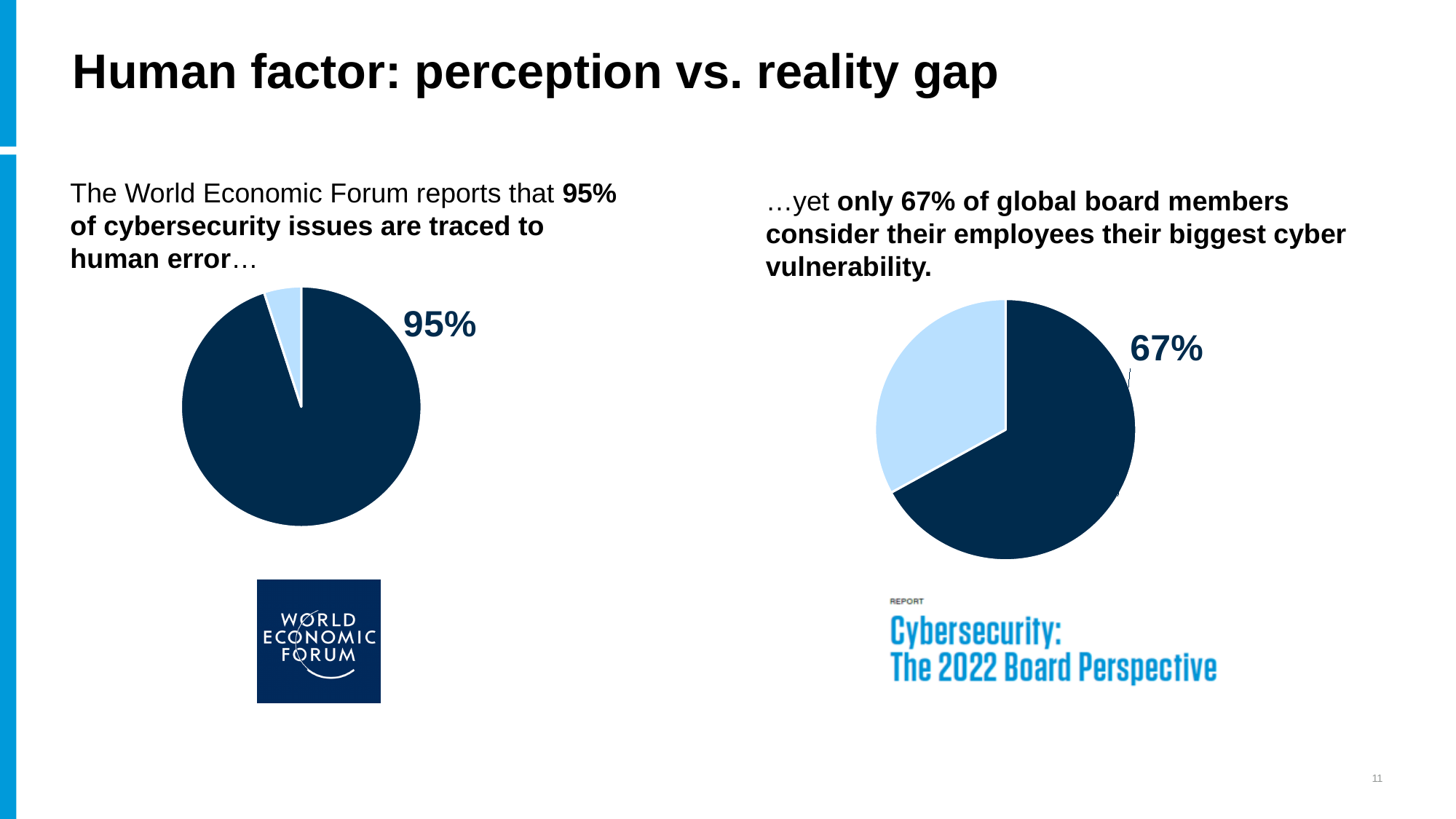
In the right pie chart, is the labelled slice greater or less than 50% of the pie? greater How many slices does the right pie chart have? 2 In the right pie chart, what share of the pie does the light-blue slice represent? 33% What is the difference between the labelled share in the left pie chart (95%) and the labelled share in the right pie chart (67%)? 28 percentage points In the right pie chart, what percentage is shown for the large dark slice? 67% What colour is the slice labelled 95% in the left pie chart? Dark navy blue How many slices does the left pie chart have? 2 What kind of chart is the left chart on the slide? Pie chart What kind of chart is the right chart on the slide? Pie chart Which is larger: the labelled share in the left pie chart or the labelled share in the right pie chart? The left pie chart (95%) In the left pie chart, what percentage is shown for the large dark slice? 95% In the left pie chart, what share of the pie does the small light-blue slice represent? 5%